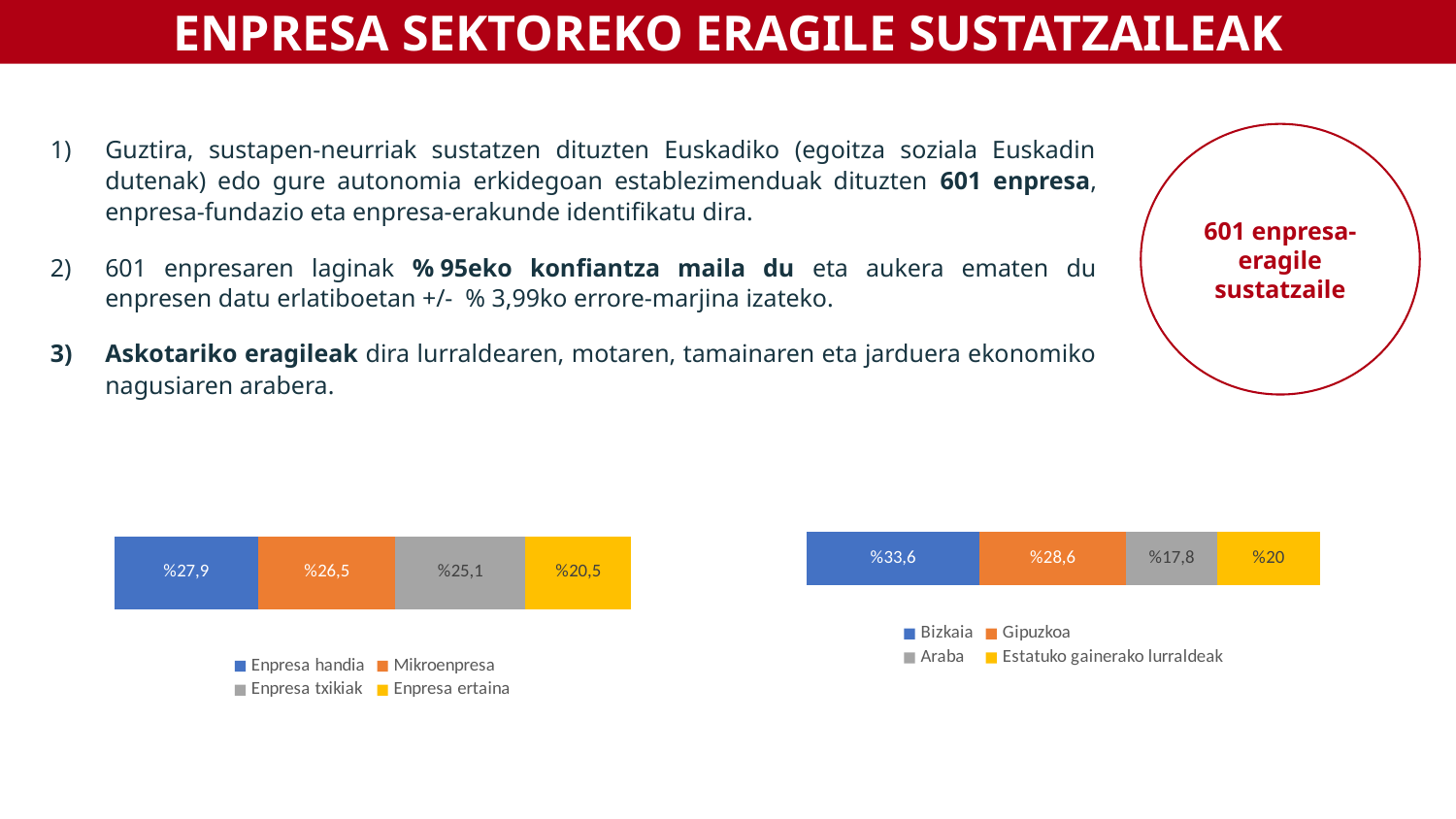
In the right chart, what is the value for Araba? %17,8 In the right chart, which is larger, Gipuzkoa or Estatuko gainerako lurraldeak? Gipuzkoa In the left chart, what is the value for Enpresa handia? %27,9 In the right chart, which series has the lowest value? Araba In the left chart, which series has the highest value? Enpresa handia In the left chart, which series has the lowest value? Enpresa ertaina In the left chart, what is the value for Enpresa ertaina? %20,5 In the right chart, what is the value for Bizkaia? %33,6 In the left chart, what is the difference between Mikroenpresa and Enpresa txikiak? %1,4 In the left chart, how many series does the legend list? 4 What kind of chart is the right chart? Stacked bar chart In the right chart, what is the difference between Bizkaia and Gipuzkoa? %5